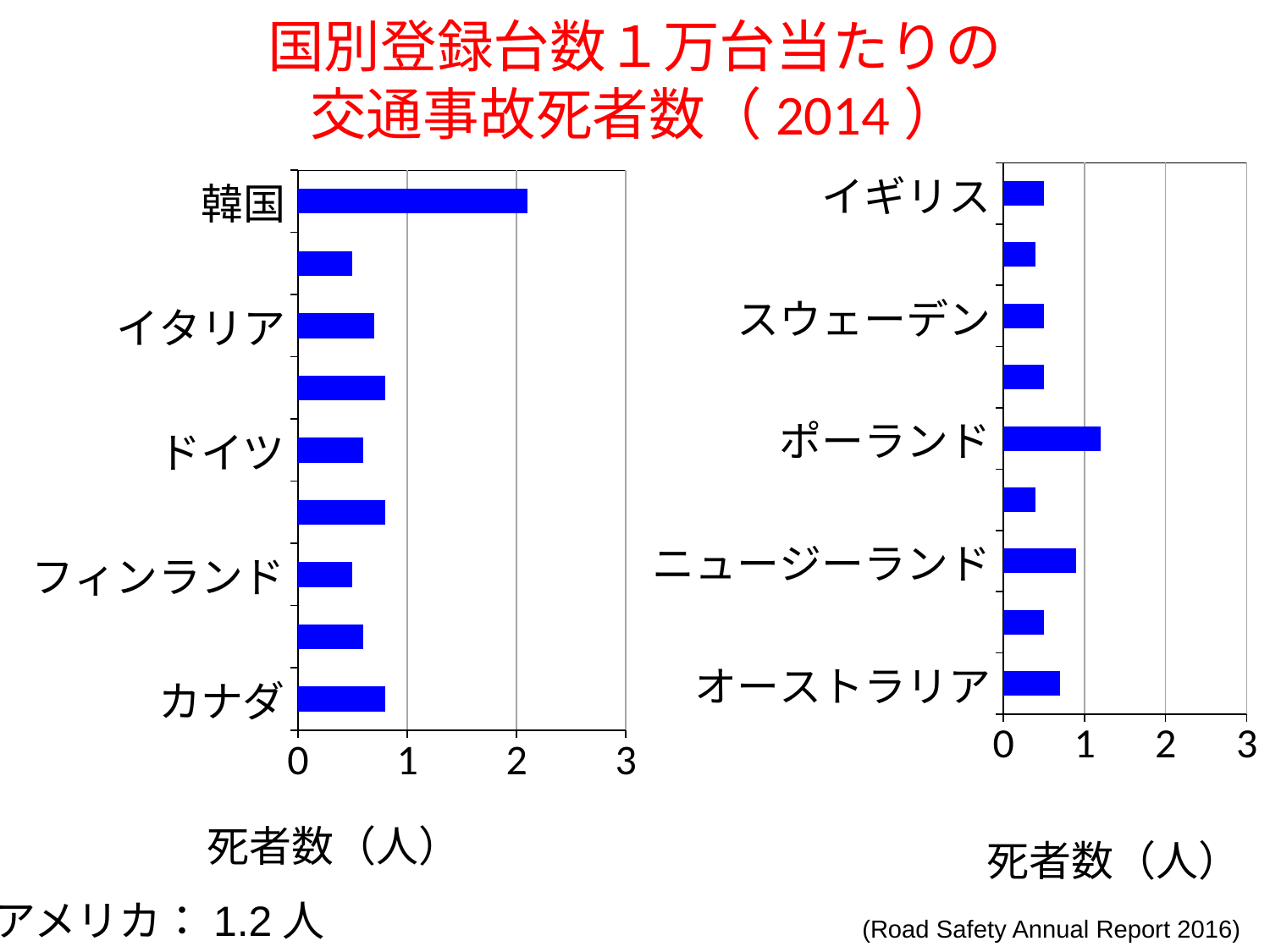
In the right chart, which is larger, the value for ニュージーランド or the value for イギリス? ニュージーランド In the left chart, is the value for イタリア greater or less than 1? less What is the x-axis label of the right chart? 死者数（人） In the left chart, is the value for 韓国 greater or less than 1? greater How many bars are plotted in the left chart? 9 In the right chart, is the value for ポーランド greater or less than 1? greater In the right chart, which country has the highest value? ポーランド In the left chart, which country has the highest value? 韓国 What is the maximum value shown on the x axis of the left chart? 3 In the left chart, which is larger, the value for 韓国 or the value for カナダ? 韓国 What kind of chart is the left chart on the slide? bar chart